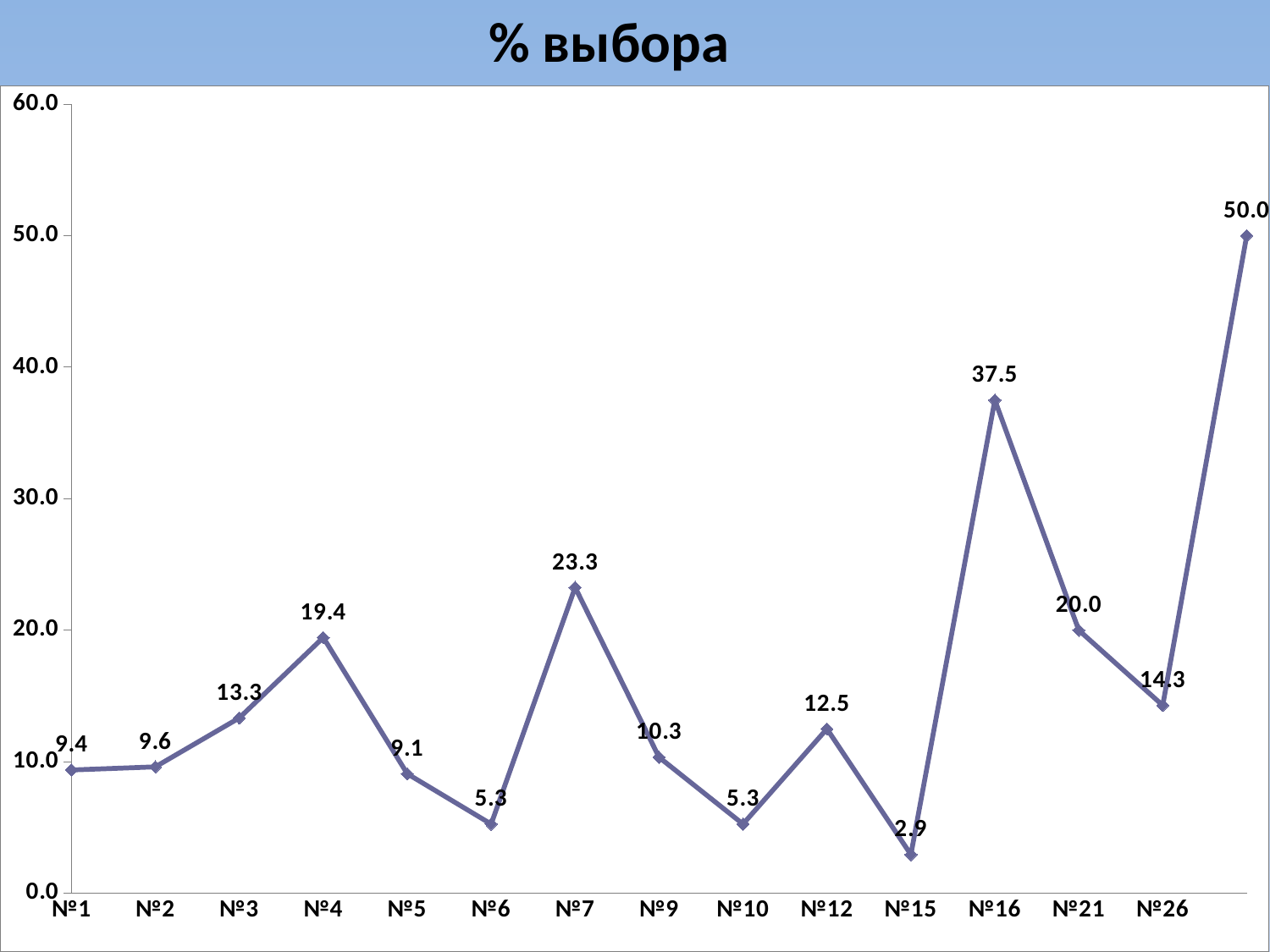
Do the values rise or fall from №1 to №4? rise Which is larger, the value for №7 or the value for №12? №7 What is the value for №16? 37.5 What is the highest value plotted on the chart? 50.0 What is the value for №15? 2.9 Is the value for №26 greater or less than 20.0? less What is the value for №4? 19.4 How many data points are plotted on the line? 15 What is the title of the chart? % выбора Which labelled category has the lowest value? №15 What is the difference between the values for №16 and №21? 17.5 What type of chart is shown on the slide? line chart